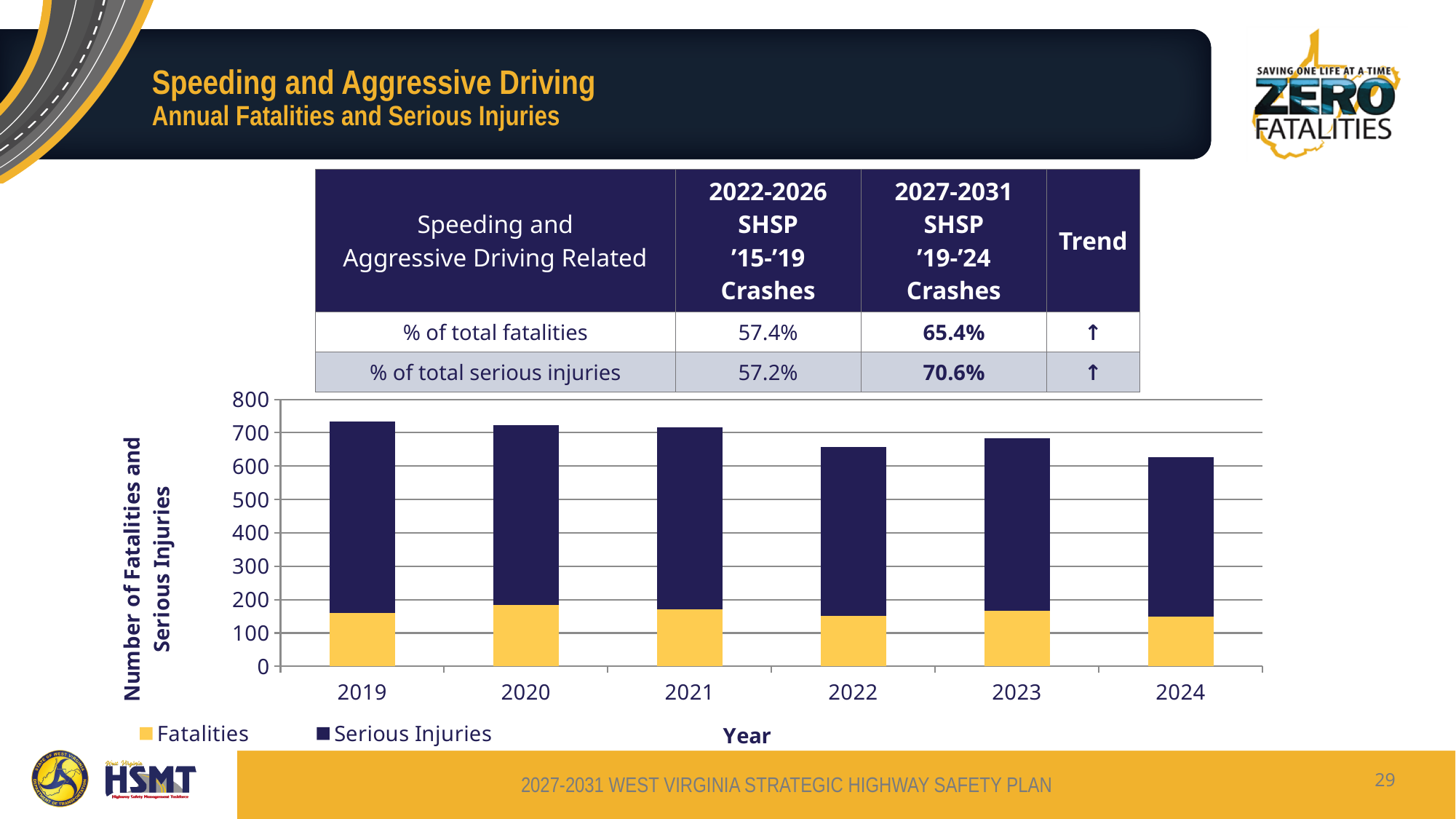
Which year has the larger total bar, 2019 or 2024? 2019 What is the title of the y axis of the chart? Number of Fatalities and Serious Injuries Which year has the highest number of fatalities? 2020 Do the total bars generally rise or fall from 2019 to 2024? fall Which year has the lowest total of fatalities and serious injuries? 2024 Is the total bar for 2024 greater or less than 700? less Is the total bar for 2019 greater or less than 700? greater Is the number of fatalities in 2022 greater or less than 200? less What kind of chart is shown on the slide? Stacked bar chart How many series does the chart legend list? 2 How many years are shown on the x axis of the chart? 6